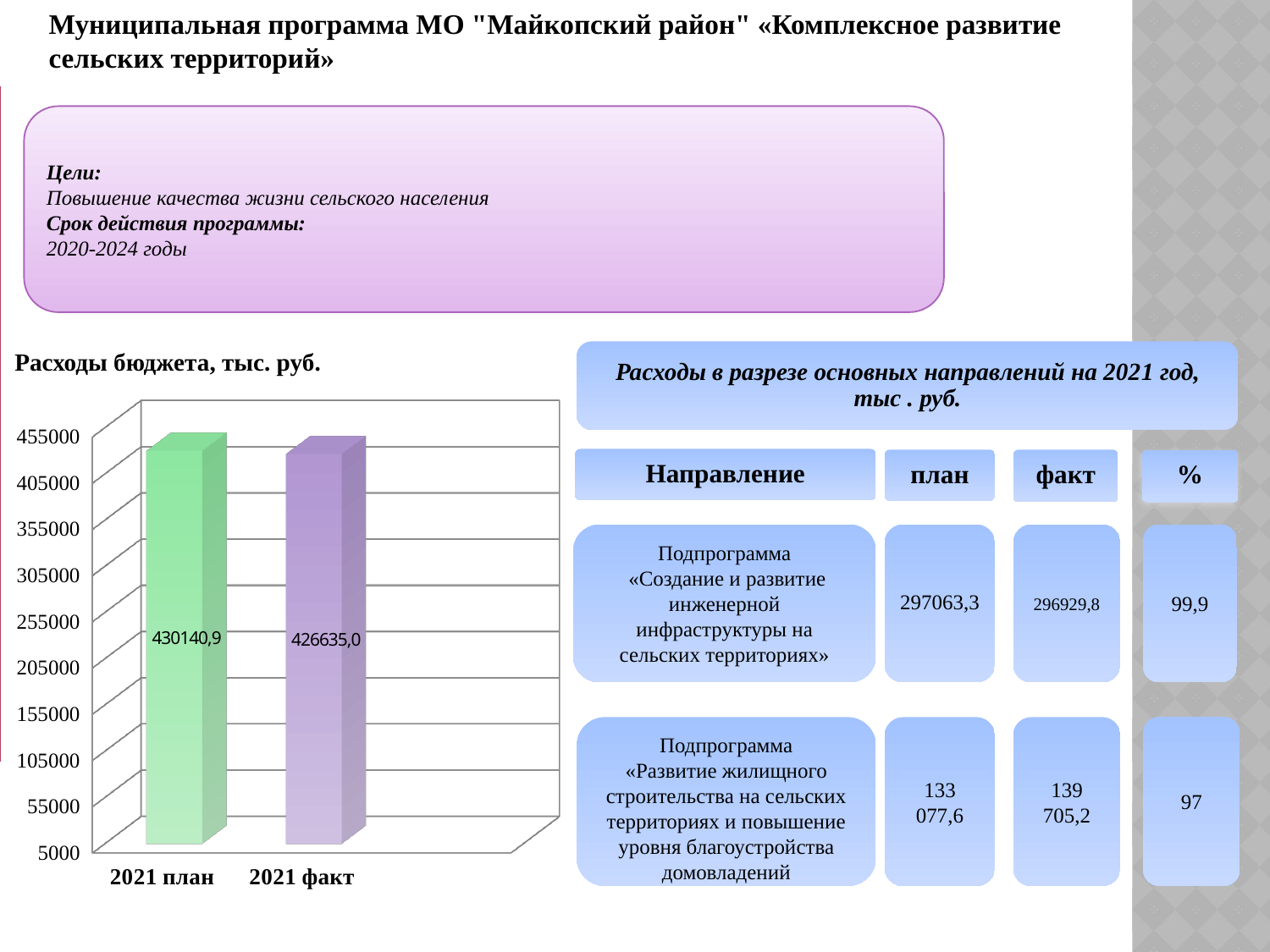
In the chart "Расходы бюджета, тыс. руб.", is the value for "2021 план" larger or smaller than the value for "2021 факт"? larger Which category has the higher value in the chart "Расходы бюджета, тыс. руб."? 2021 план What is the value of the "2021 план" bar in the chart "Расходы бюджета, тыс. руб."? 430140,9 Do the values rise or fall from "2021 план" to "2021 факт" in the chart "Расходы бюджета, тыс. руб."? fall In the chart "Расходы бюджета, тыс. руб.", is the value for "2021 факт" greater or less than 405000? greater What colour is the "2021 план" bar in the chart "Расходы бюджета, тыс. руб."? green Which category has the lower value in the chart "Расходы бюджета, тыс. руб."? 2021 факт What is the title of the bar chart on the left of the slide? Расходы бюджета, тыс. руб. What type of chart is "Расходы бюджета, тыс. руб."? bar chart How many bars are shown in the chart "Расходы бюджета, тыс. руб."? 2 What is the difference between the "2021 план" and "2021 факт" values in the chart "Расходы бюджета, тыс. руб."? 3505,9 What is the value of the "2021 факт" bar in the chart "Расходы бюджета, тыс. руб."? 426635,0